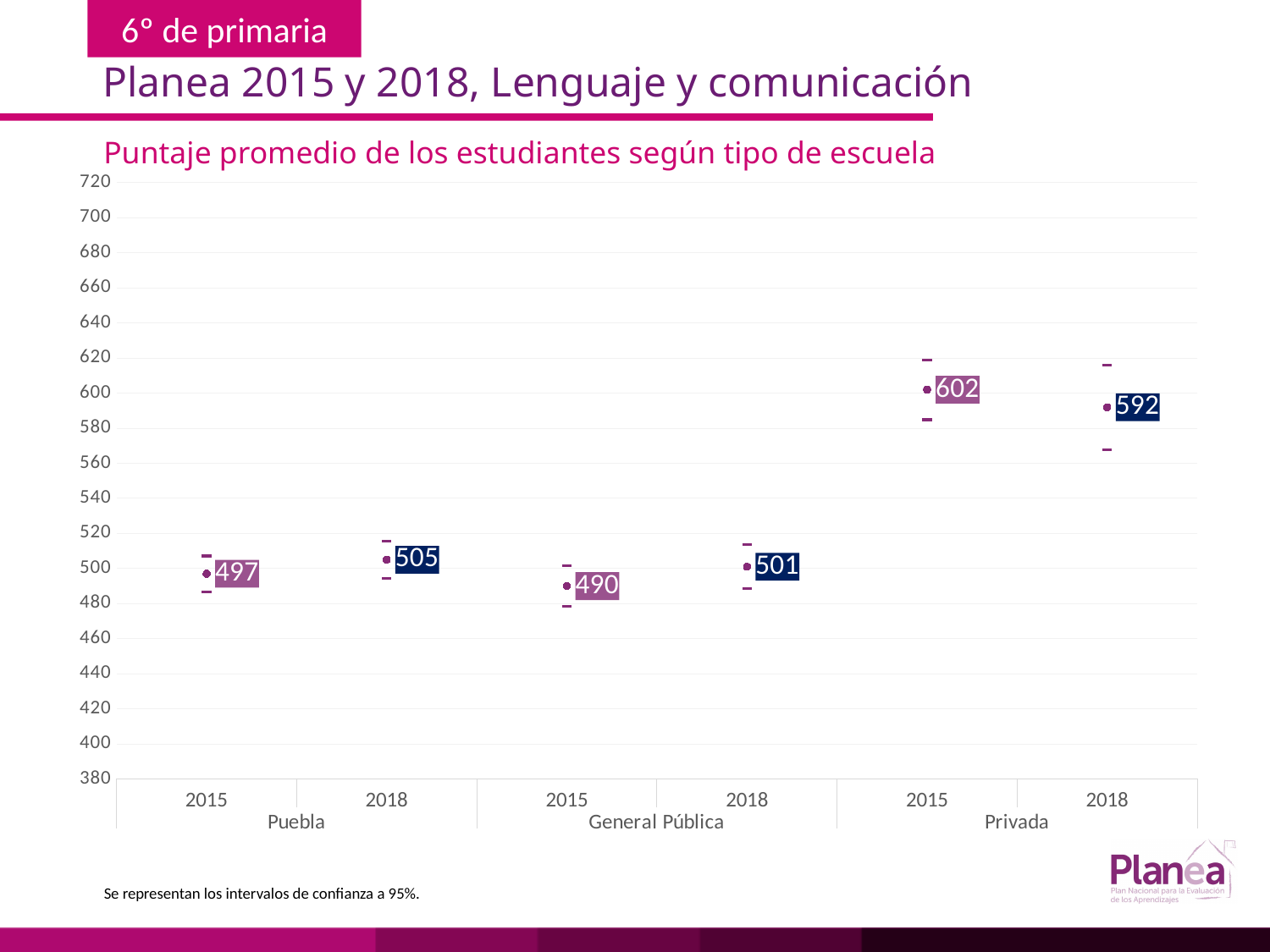
Which is larger, the Puebla 2018 score or the General Pública 2018 score? Puebla 2018 What is the difference between the Privada scores in 2015 and 2018? 10 Did the Puebla score rise or fall from 2015 to 2018? rise Is the Privada 2015 score greater or less than 600? greater Which group and year has the lowest average score? General Pública 2015 What is the difference between the General Pública scores in 2018 and 2015? 11 What is the average score for Privada in 2018? 592 How many data points are plotted on the chart? 6 What is the average score for Puebla in 2015? 497 What is the average score for General Pública in 2015? 490 What is the title of the chart? Puntaje promedio de los estudiantes según tipo de escuela Which group and year has the highest average score? Privada 2015